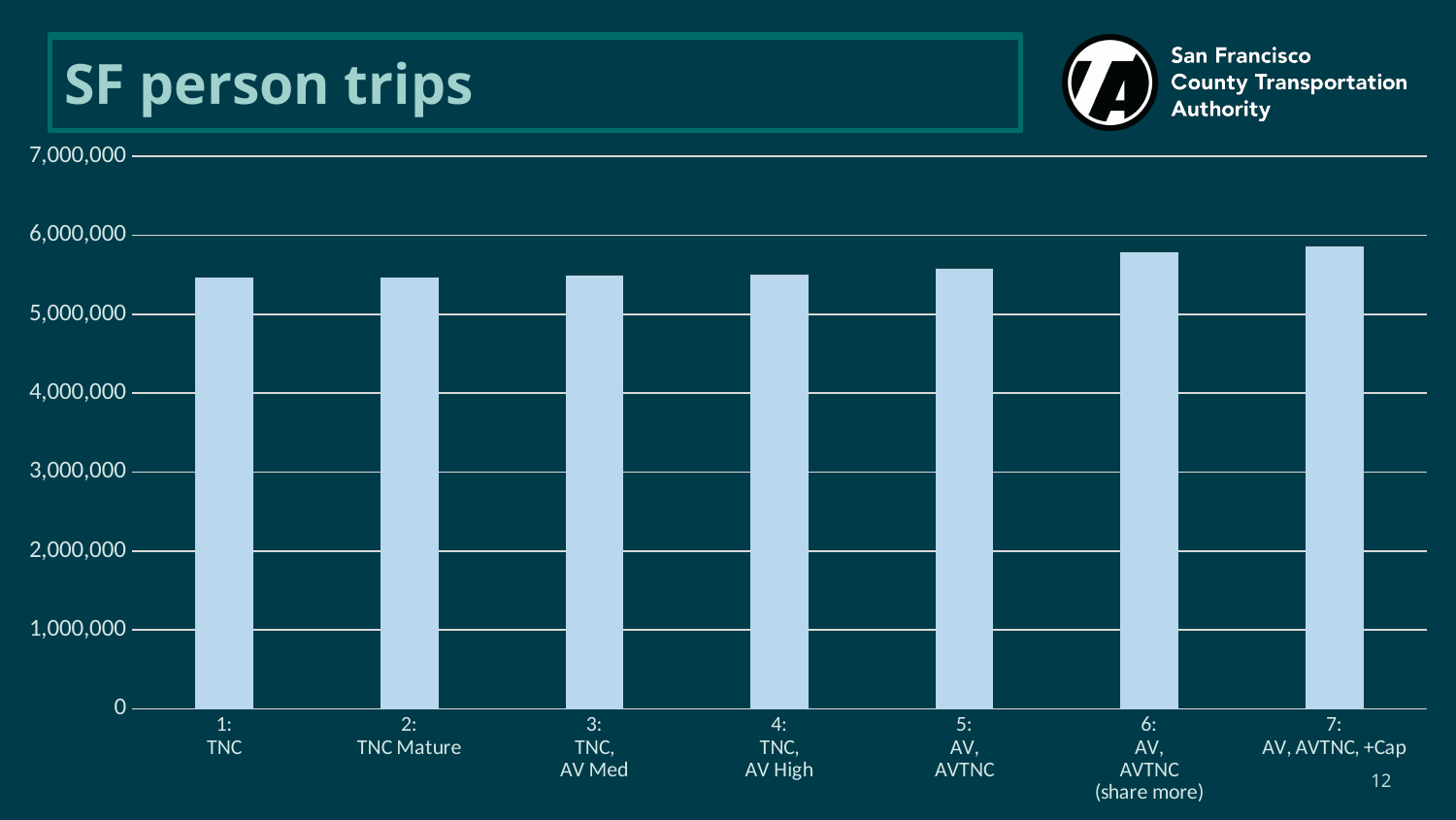
Is the value for scenario 7: AV, AVTNC, +Cap greater or less than 6,000,000? less Which scenario has the highest number of person trips? 7: AV, AVTNC, +Cap Do the values generally rise or fall moving from scenario 1 to scenario 7 along the x axis? rise Which is larger, the value for scenario 7: AV, AVTNC, +Cap or scenario 1: TNC? 7: AV, AVTNC, +Cap How many scenario categories are plotted on the x axis? 7 Which is larger, the value for scenario 6: AV, AVTNC (share more) or scenario 5: AV, AVTNC? 6: AV, AVTNC (share more) What is the title of the chart? SF person trips What kind of chart is shown on the slide? bar chart Is the value for scenario 4: TNC, AV High greater or less than 6,000,000? less What is the highest value labelled on the y axis? 7,000,000 Is the value for scenario 6: AV, AVTNC (share more) greater or less than 5,000,000? greater